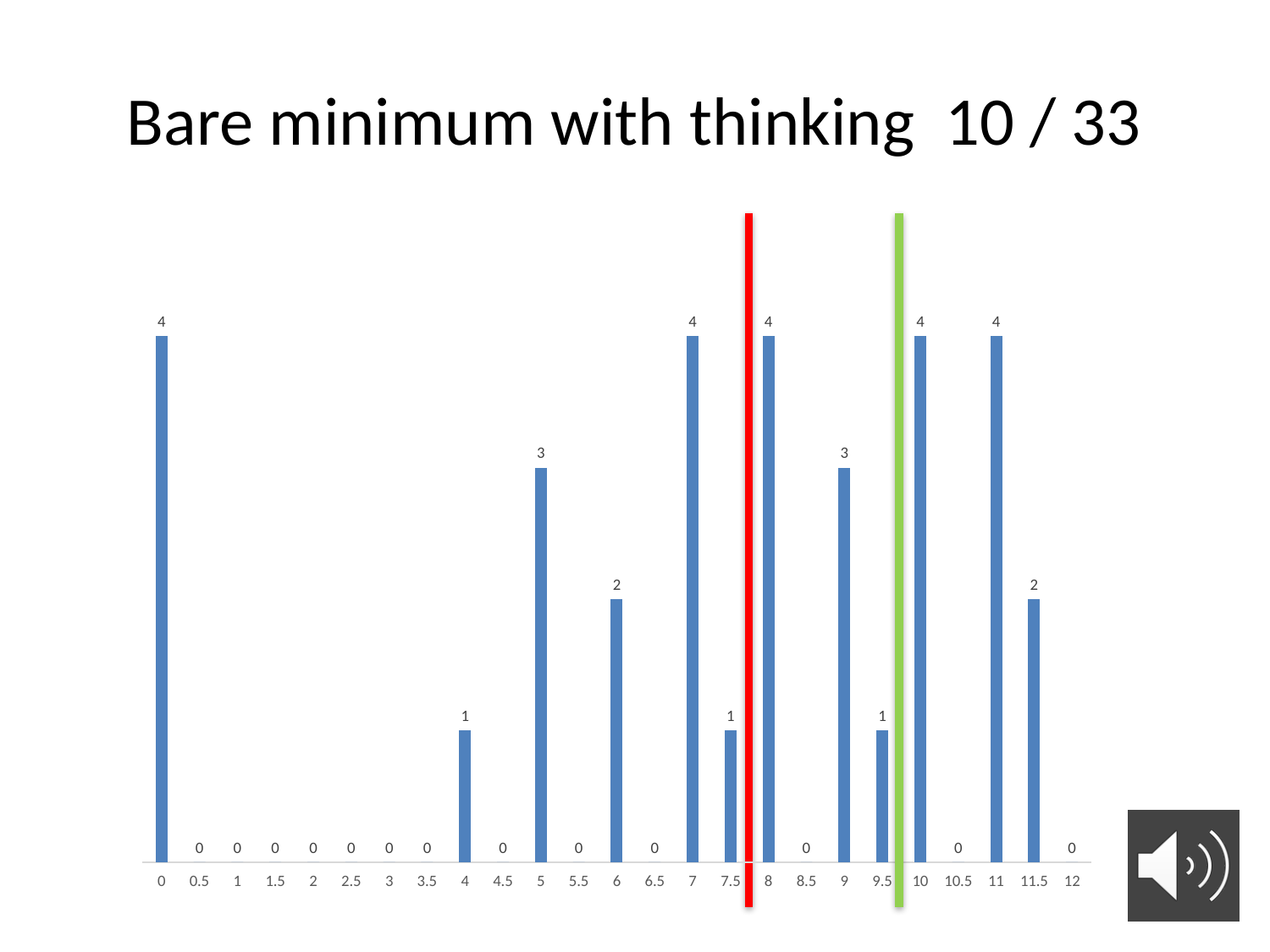
What is the difference between the values for category 9 and category 9.5? 2 What is the value for category 5? 3 What is the title of the slide? Bare minimum with thinking 10 / 33 How many categories are shown on the x axis? 25 What is the value for category 6? 2 What kind of chart is shown on the slide? bar chart What is the value for category 7.5? 1 What is the value for category 8.5? 0 Which is larger, the value for category 5 or the value for category 4? 5 What is the value for category 11.5? 2 Which is larger, the value for category 11.5 or the value for category 11? 11 What is the difference between the values for category 7 and category 6? 2